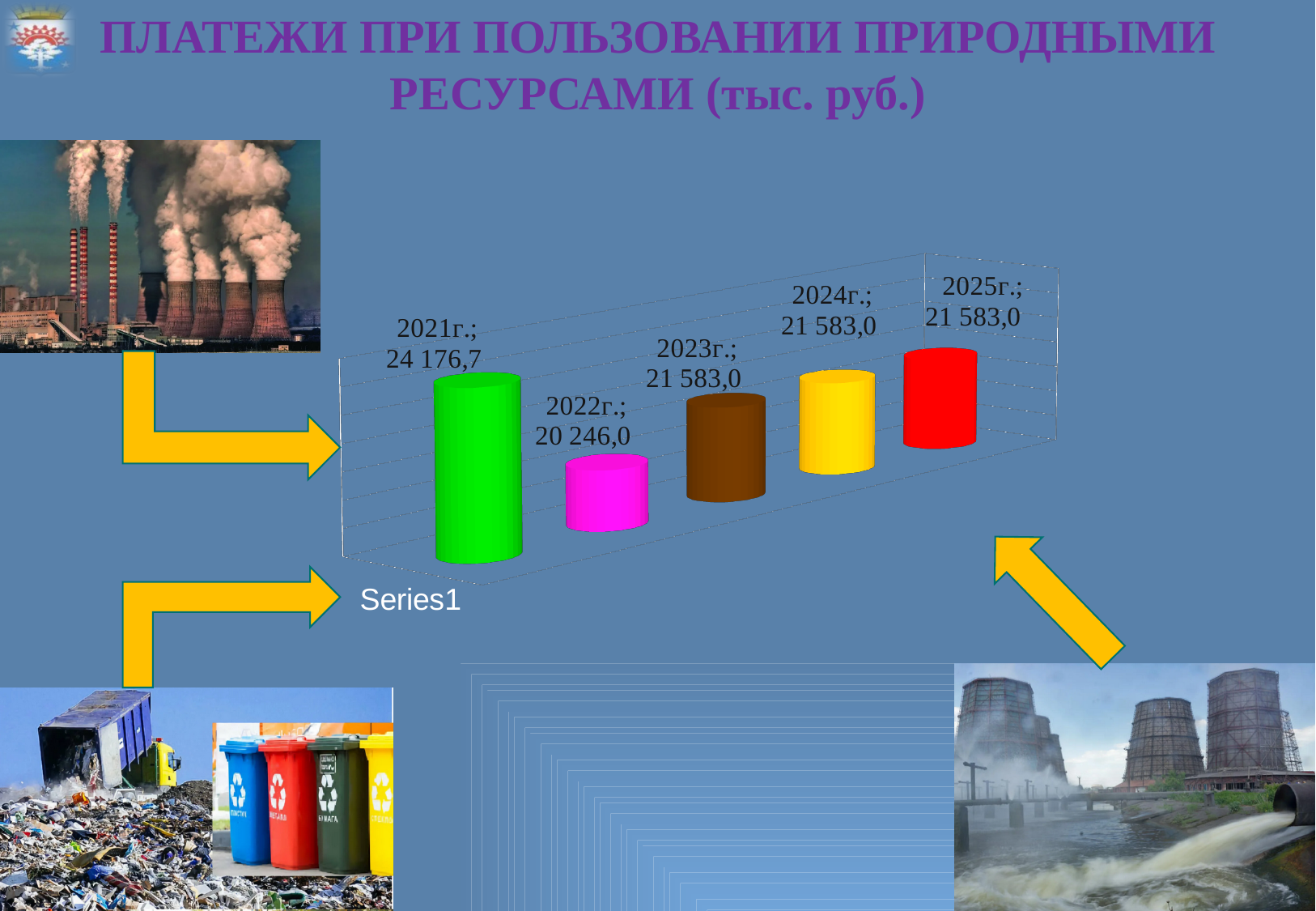
Which year has the highest value? 2021г. Which year has the lowest value? 2022г. What is the difference between the values for 2023г. and 2022г.? 1 337,0 What is the value for 2022г.? 20 246,0 Which is larger, the value for 2021г. or the value for 2025г.? 2021г. What is the value for 2021г.? 24 176,7 What is the difference between the values for 2021г. and 2022г.? 3 930,7 How many years are plotted on the chart? 5 What kind of chart is shown on the slide? bar chart What is the value for 2024г.? 21 583,0 What is the unit given in the chart title? тыс. руб. Do the values rise or fall from 2021г. to 2022г.? fall